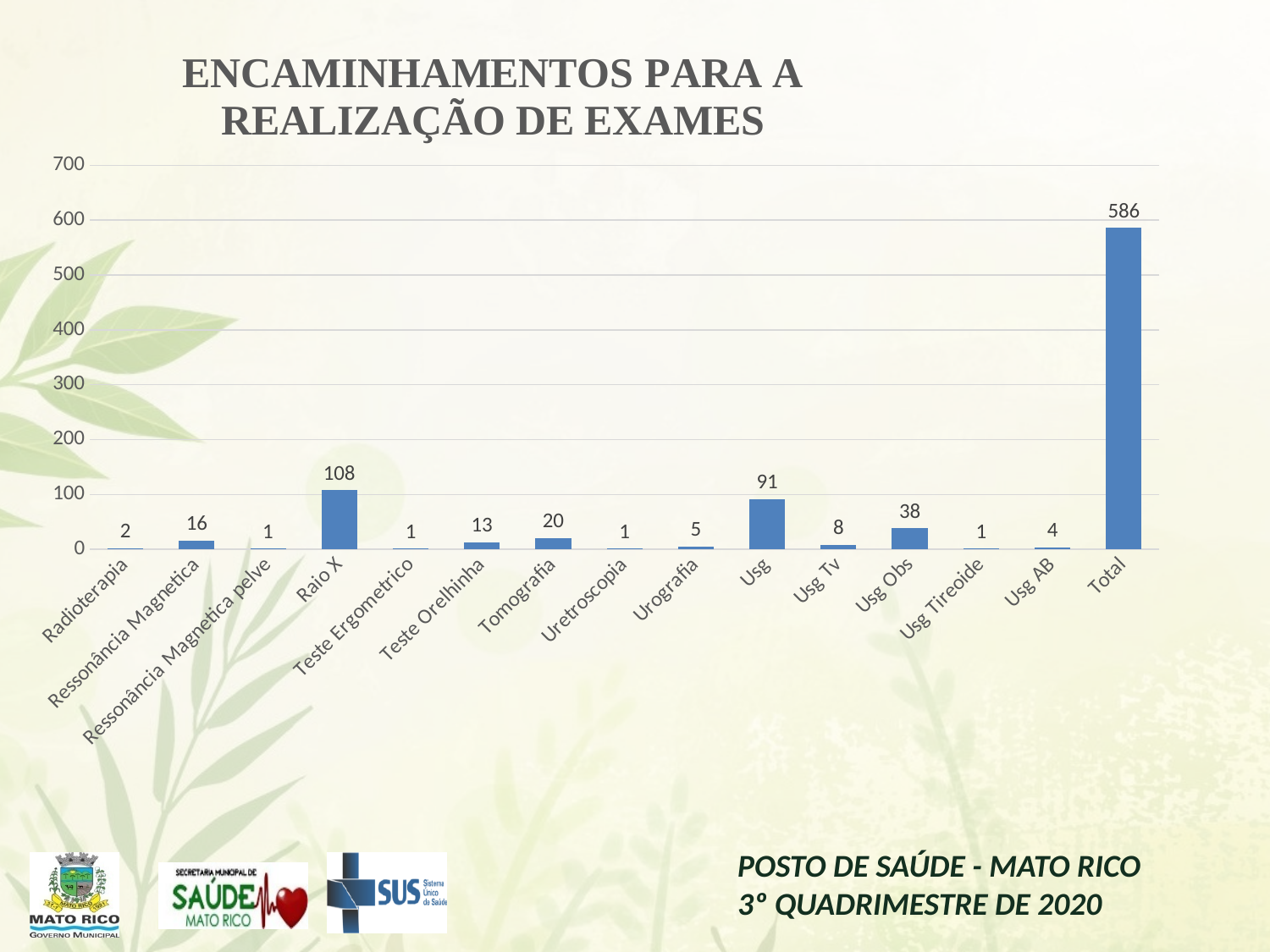
What kind of chart is shown on the slide? bar chart What is the difference between the values for Raio X and Usg? 17 Excluding the Total bar, which exam category has the highest value? Raio X Which is larger, the value for Usg Obs or the value for Ressonância Magnetica? Usg Obs Is the value for Total greater or less than 500? greater What is the value for Raio X? 108 What is the title of the chart? ENCAMINHAMENTOS PARA A REALIZAÇÃO DE EXAMES How many categories are shown on the x axis? 15 What is the value shown for the Total bar? 586 What is the value for Tomografia? 20 Which category has the highest value on the chart? Total What is the value for Usg Obs? 38